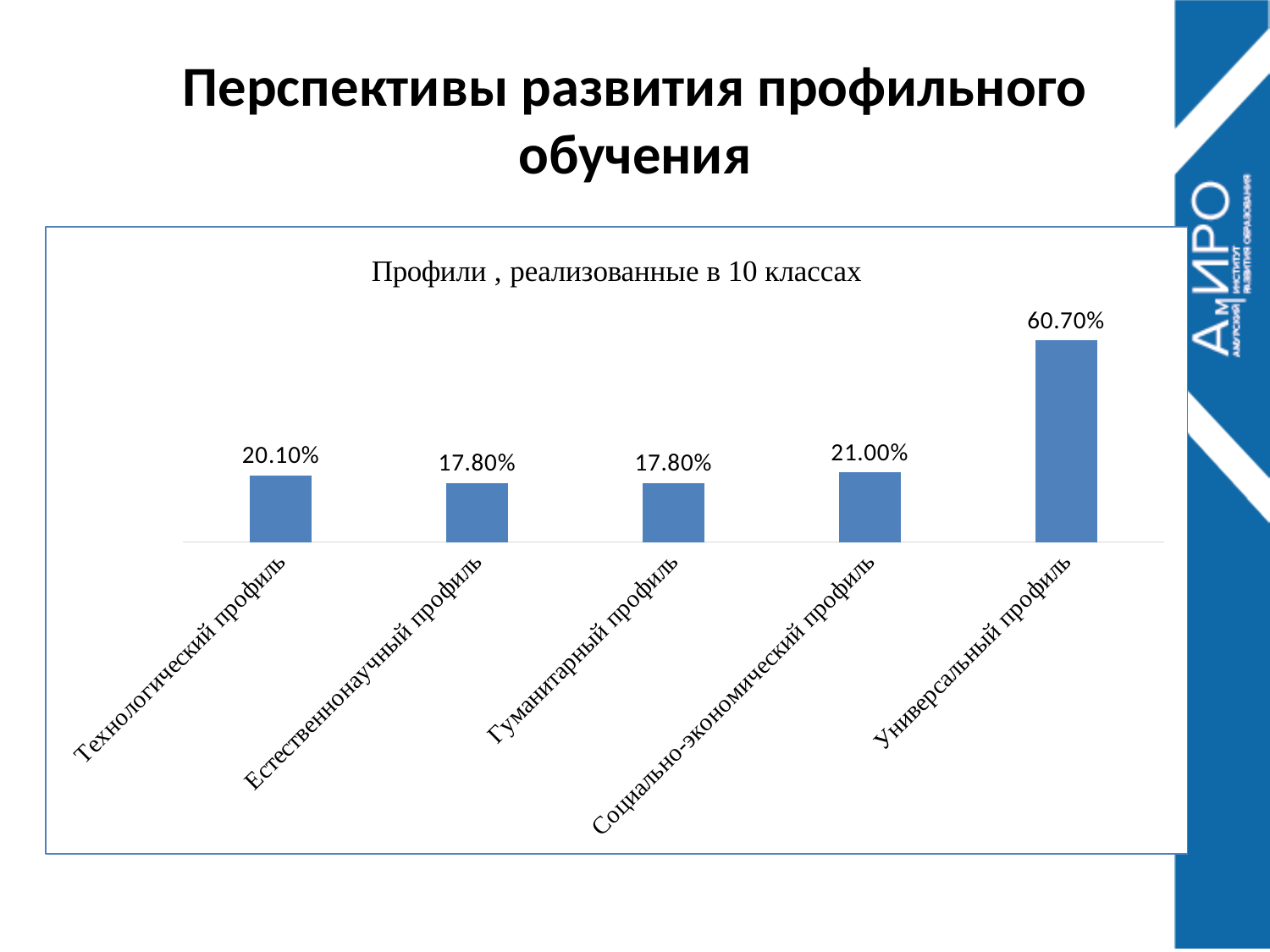
How many categories are shown in the chart? 5 What is the title of the chart? Профили , реализованные в 10 классах What is the difference between the values for Технологический профиль and Естественнонаучный профиль? 2.30% What is the difference between the values for Универсальный профиль and Социально-экономический профиль? 39.70% What is the value for Технологический профиль? 20.10% Which category has the highest value? Универсальный профиль What is the value for Гуманитарный профиль? 17.80% What is the value for Универсальный профиль? 60.70% What is the value for Социально-экономический профиль? 21.00% What kind of chart is shown on the slide? Bar chart Which is larger, the value for Социально-экономический профиль or the value for Гуманитарный профиль? Социально-экономический профиль Which two categories share the same value of 17.80%? Естественнонаучный профиль and Гуманитарный профиль